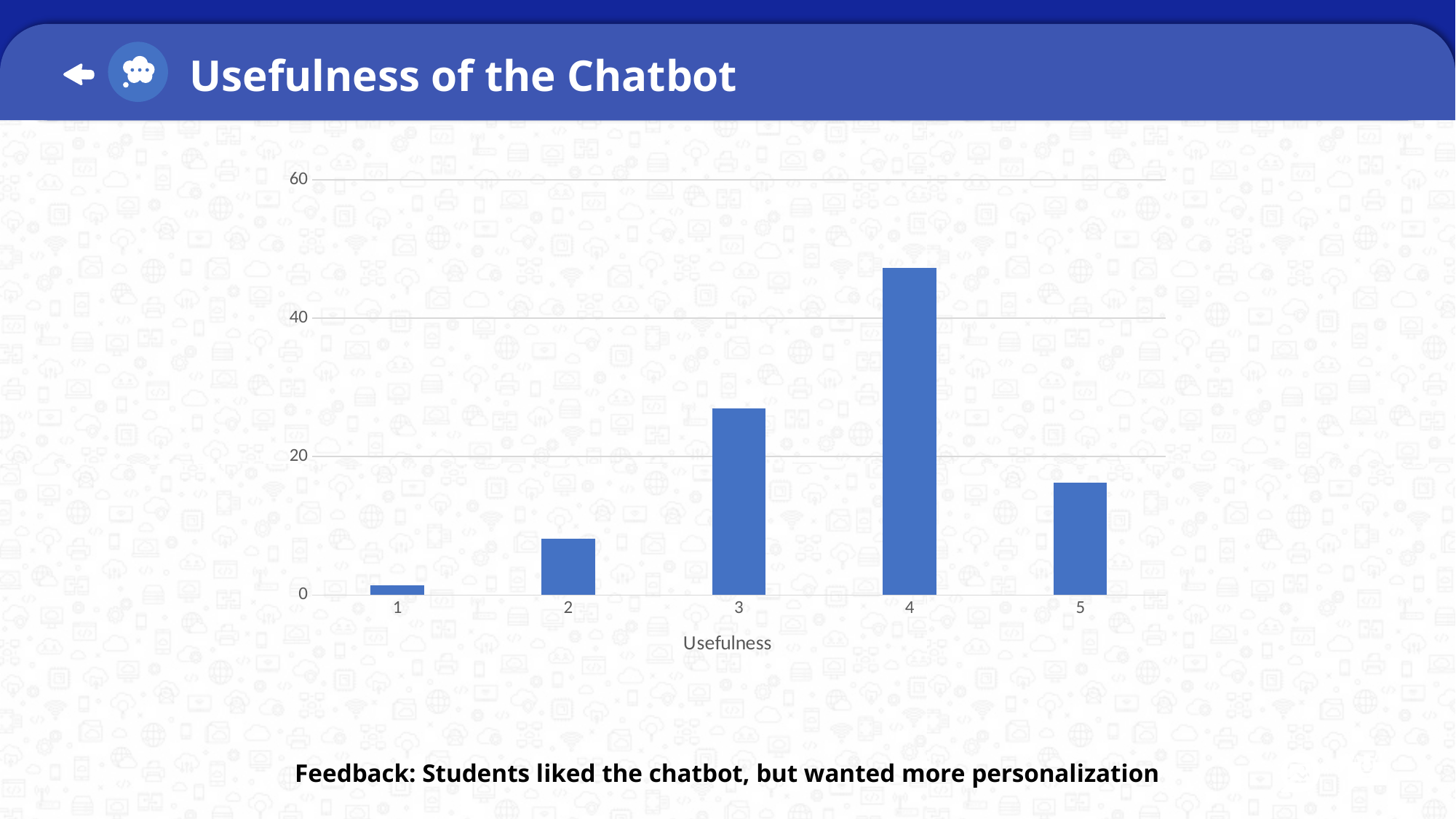
Is the value for category 2 greater or less than 20? less What kind of chart is shown on the slide? bar chart Is the value for category 5 greater or less than 20? less Is the value for category 3 greater or less than 20? greater Which is larger, the value for category 3 or the value for category 5? 3 How many categories are shown on the x axis of the chart? 5 Which category has the lowest bar in the chart? 1 Do the bar values rise or fall from category 1 to category 4? rise Which category has the highest bar in the chart? 4 What is the title of the x axis of the chart? Usefulness Which is larger, the value for category 2 or the value for category 5? 5